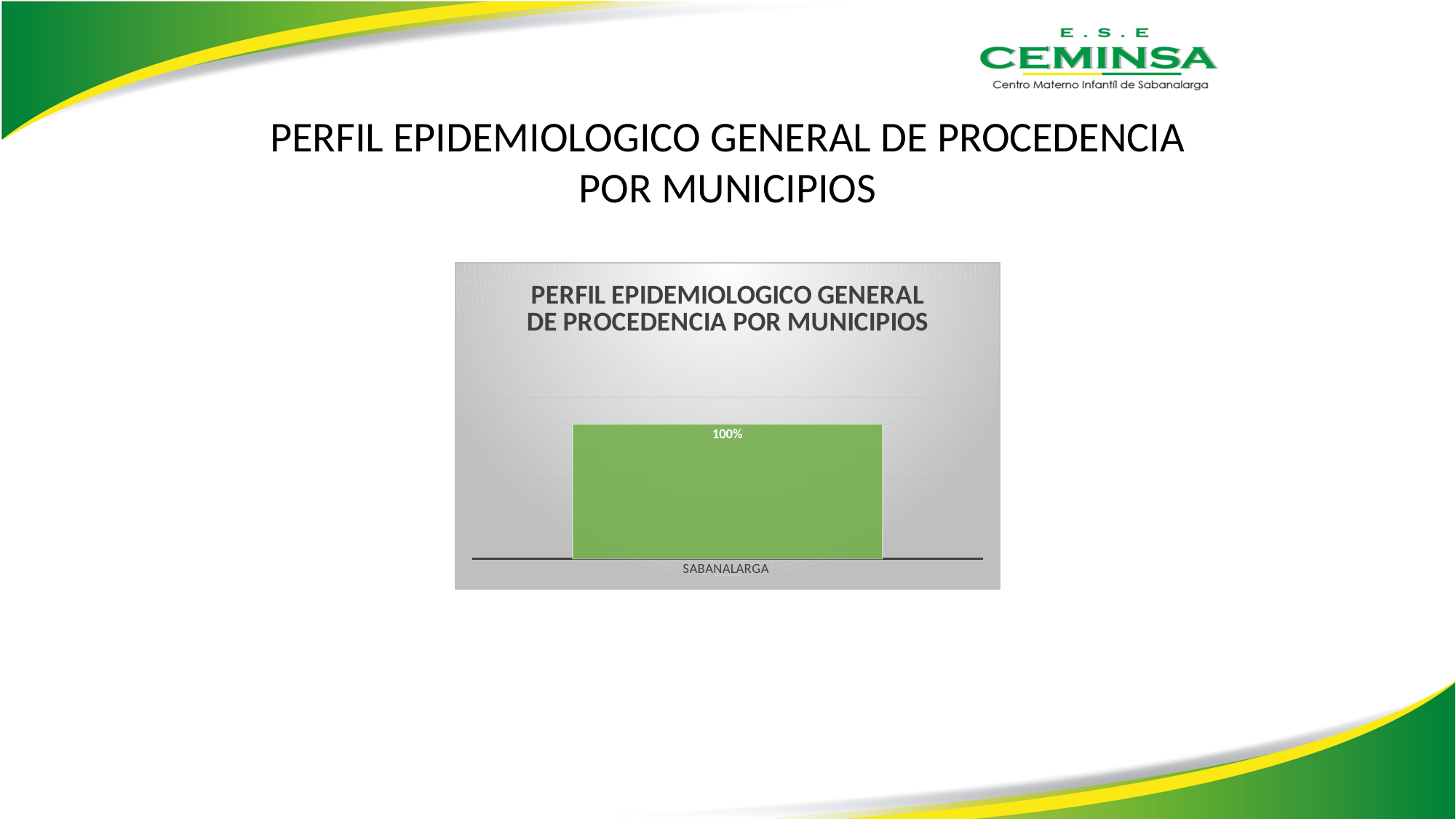
Which municipality is shown on the x axis of the chart? SABANALARGA Which category has the highest value in the chart? SABANALARGA What is the value shown for SABANALARGA? 100% What is the title of the chart? PERFIL EPIDEMIOLOGICO GENERAL DE PROCEDENCIA POR MUNICIPIOS How many categories are plotted on the x axis of the chart? 1 What kind of chart is shown on the slide? bar chart